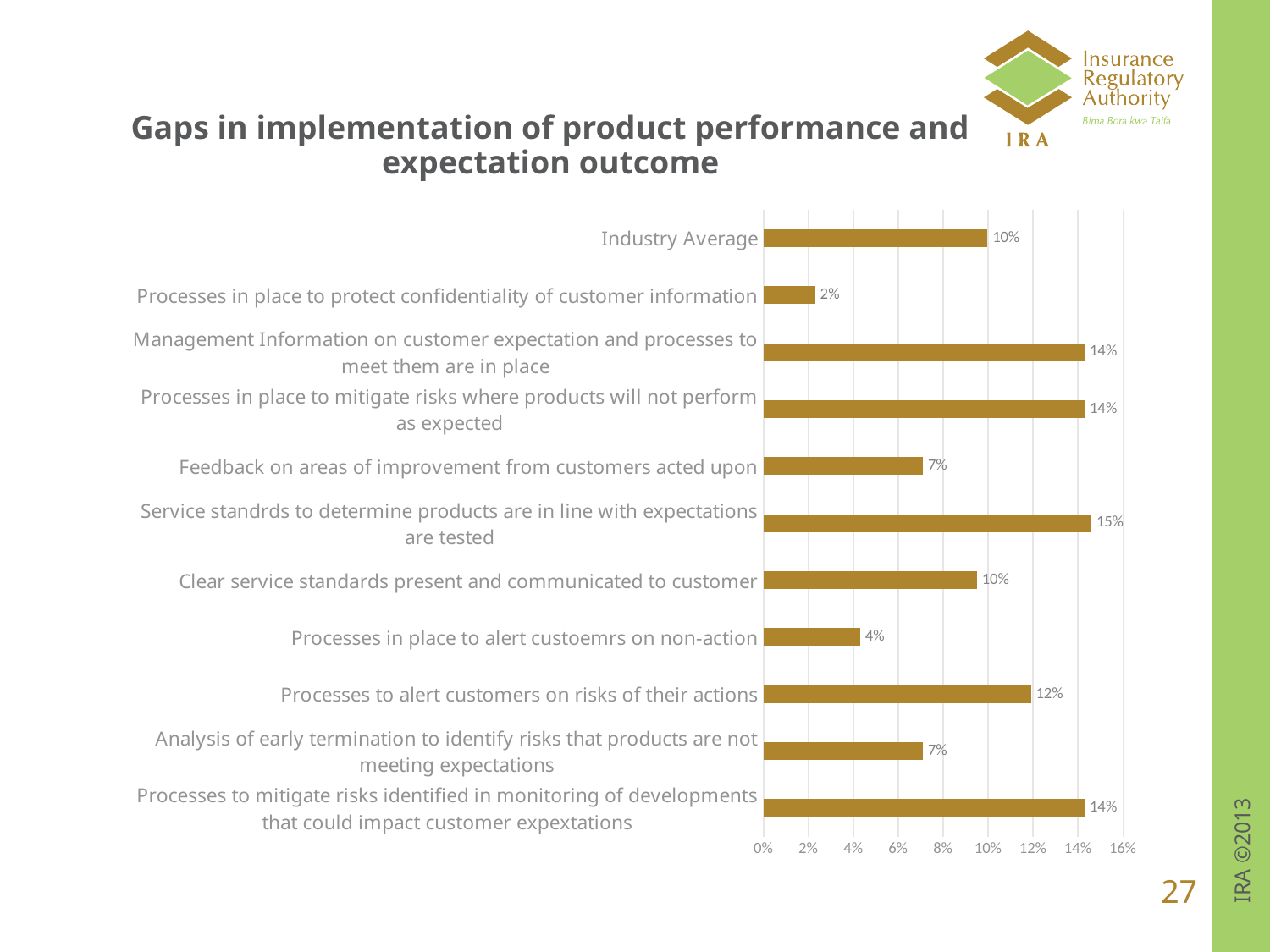
What is the value for Industry Average? 10% What is the value for "Feedback on areas of improvement from customers acted upon"? 7% How many categories are shown in the chart? 11 What is the value for "Processes in place to protect confidentiality of customer information"? 2% Which category has the lowest value? Processes in place to protect confidentiality of customer information Which category has the highest value? Service standrds to determine products are in line with expectations are tested What kind of chart is shown on the slide? Bar chart What is the difference between the value for "Service standrds to determine products are in line with expectations are tested" and the Industry Average? 5% What is the title of the slide? Gaps in implementation of product performance and expectation outcome What is the value for "Processes to alert customers on risks of their actions"? 12% What is the difference between the value for "Processes to alert customers on risks of their actions" and "Processes in place to alert custoemrs on non-action"? 8% Which is larger: the value for "Clear service standards present and communicated to customer" or the value for "Processes in place to alert custoemrs on non-action"? Clear service standards present and communicated to customer